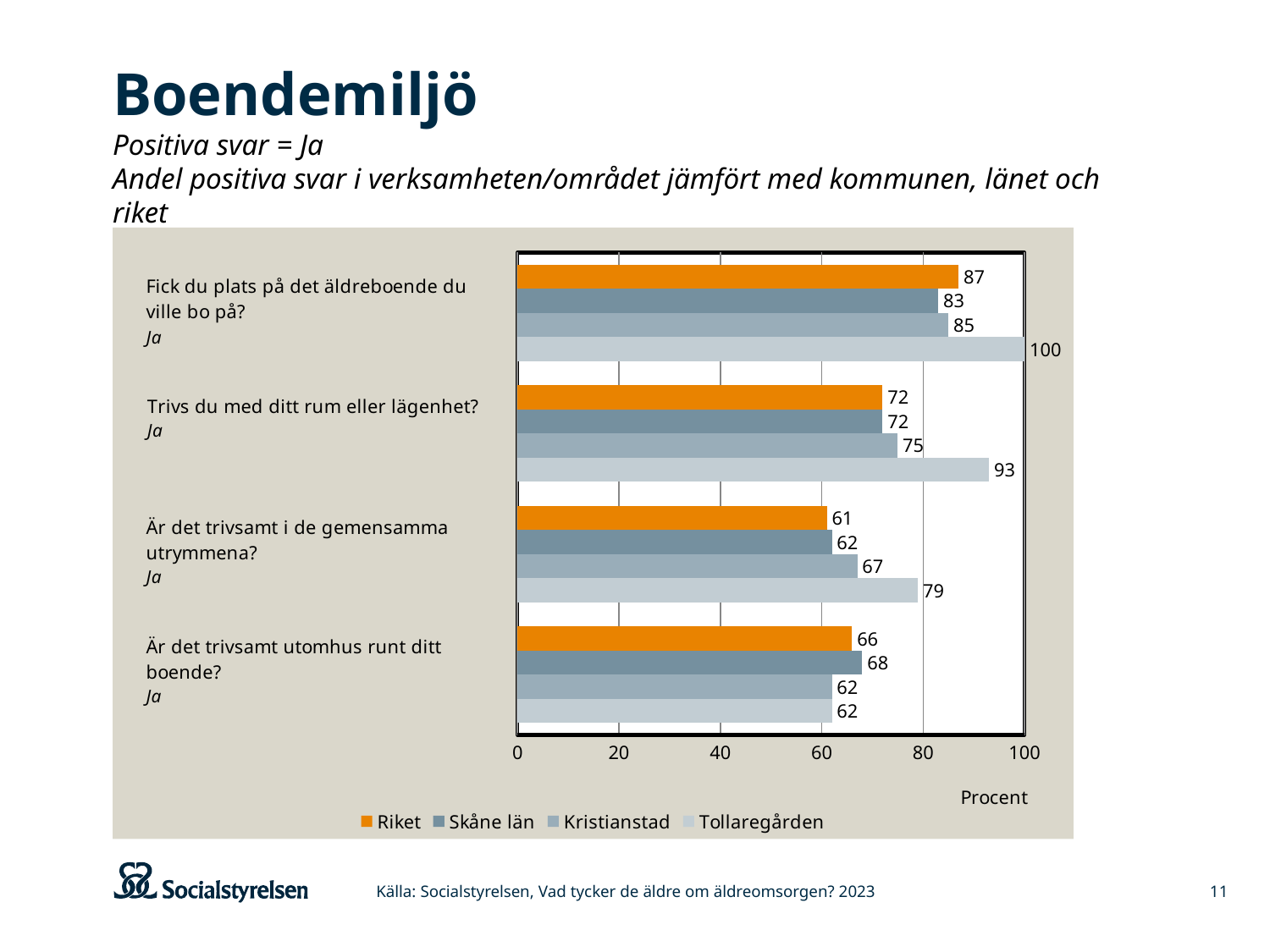
What kind of chart is shown on the slide? Bar chart What is the value for Skåne län on "Är det trivsamt utomhus runt ditt boende?"? 68 Which is larger on "Är det trivsamt utomhus runt ditt boende?": Riket or Skåne län? Skåne län What is the value for Tollaregården on "Fick du plats på det äldreboende du ville bo på?"? 100 How many questions (categories) are shown in the chart? 4 Which series has the highest value on "Trivs du med ditt rum eller lägenhet?"? Tollaregården What is the value for Kristianstad on "Är det trivsamt i de gemensamma utrymmena?"? 67 What is the label on the horizontal axis? Procent What is the value for Riket on "Trivs du med ditt rum eller lägenhet?"? 72 How many series does the legend list? 4 What is the difference between Tollaregården and Riket on "Trivs du med ditt rum eller lägenhet?"? 21 Which series has the lowest value on "Är det trivsamt i de gemensamma utrymmena?"? Riket